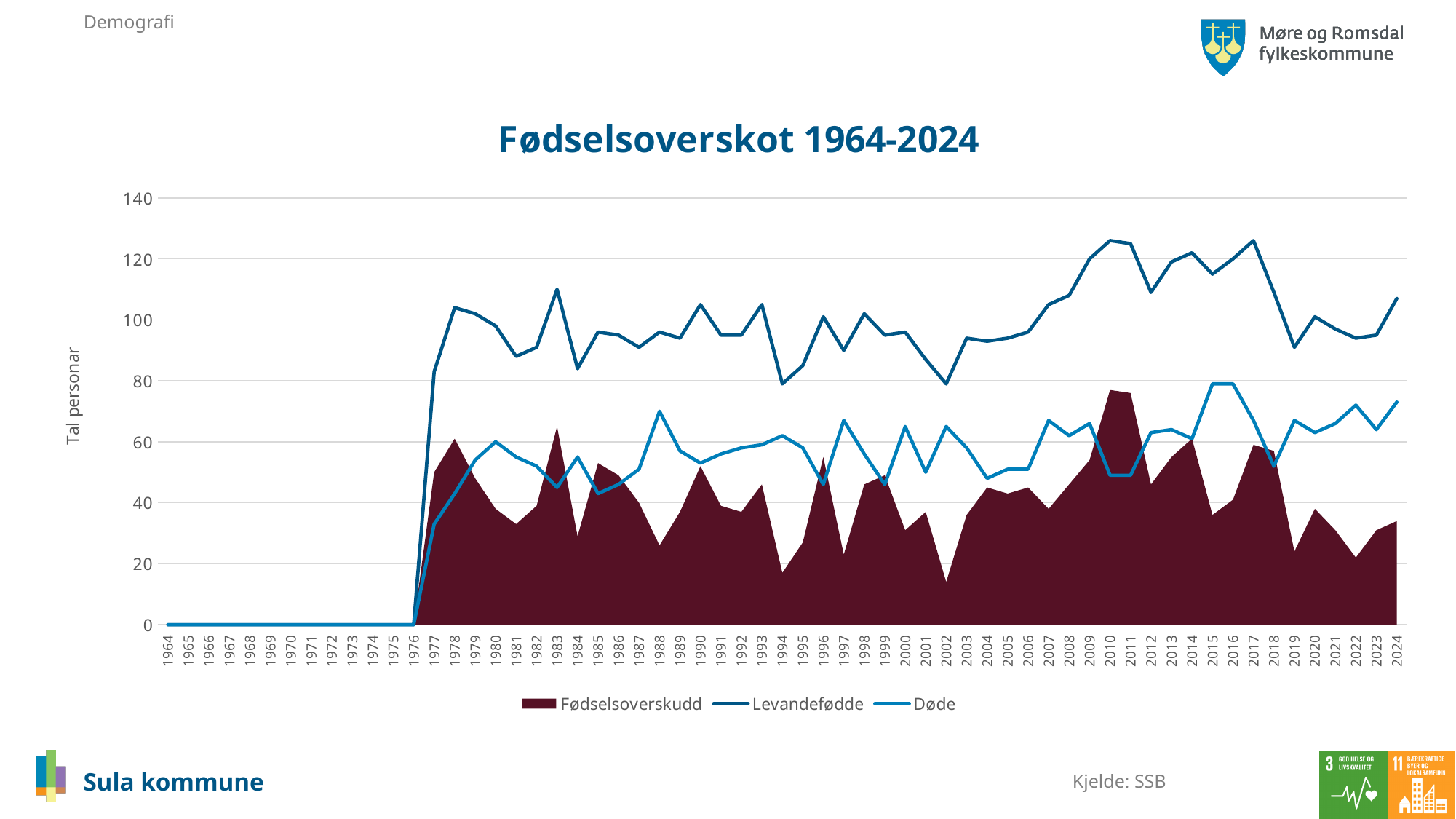
Is the value for Døde in 2015 greater or less than 60? greater Which series is drawn as a filled dark red area rather than a line? Fødselsoverskudd Is the value for Fødselsoverskudd in 2002 greater or less than 20? less What value do all three series show for 1970? 0 Is the value for Levandefødde in 2010 greater or less than 120? greater Does the Levandefødde line rise or fall from 2017 to 2019? fall What is the title of the chart? Fødselsoverskot 1964-2024 Does the Døde line rise or fall from 1976 to 1980? rise How many series does the legend list? 3 In 2024, which is larger: Levandefødde or Døde? Levandefødde